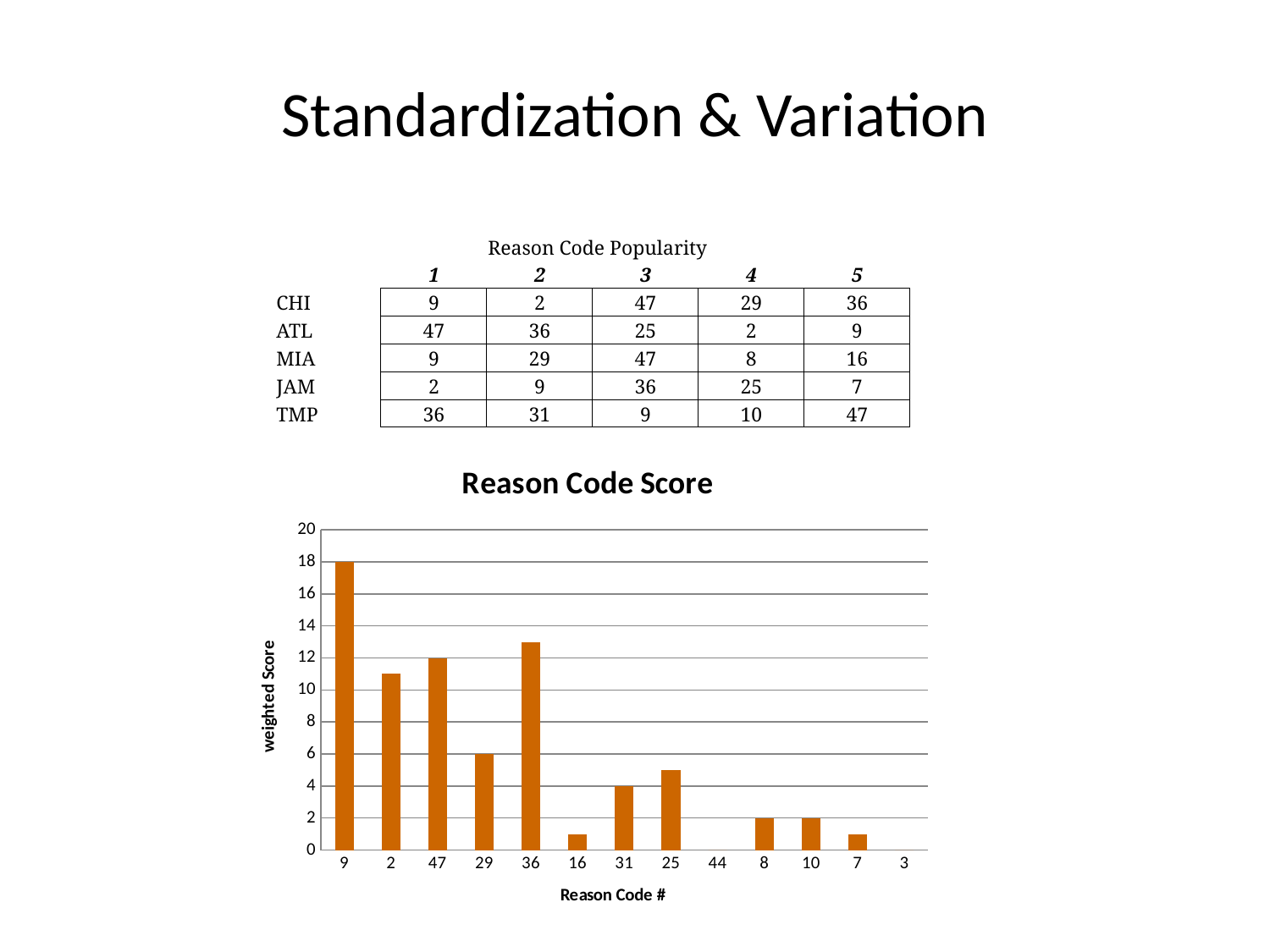
In the Reason Code Score chart, what is the weighted score for reason code 31? 4 In the Reason Code Score chart, is the weighted score for reason code 2 greater or less than 10? greater In the Reason Code Score chart, which reason code has the highest weighted score? 9 In the Reason Code Score chart, what is the weighted score for reason code 47? 12 What type of chart is shown under the title "Reason Code Score"? bar chart In the Reason Code Score chart, what is the weighted score for reason code 29? 6 In the Reason Code Score chart, which has a higher weighted score, reason code 9 or reason code 36? 9 In the Reason Code Score chart, what is the difference between the weighted scores of reason code 9 and reason code 47? 6 In the Reason Code Score chart, is the weighted score for reason code 16 greater or less than 2? less In the Reason Code Score chart, how many reason codes are shown on the x axis? 13 What is the label on the y axis of the Reason Code Score chart? weighted Score In the Reason Code Score chart, what is the weighted score for reason code 9? 18